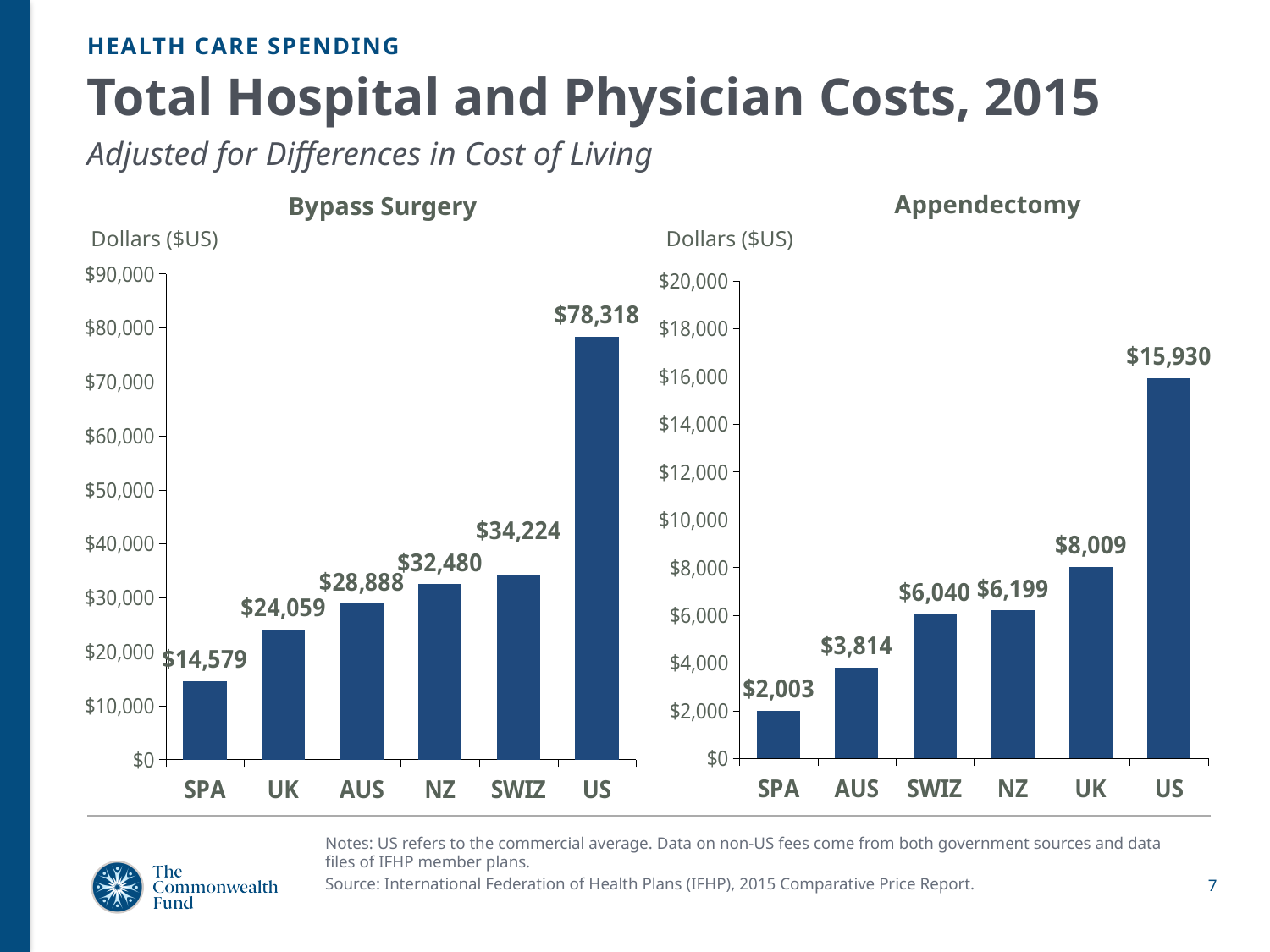
In the Bypass Surgery chart, what is the difference between the US and SWIZ values? $44,094 In the Appendectomy chart, which country has the lowest cost? SPA In the Bypass Surgery chart, which country has the highest cost? US In the Appendectomy chart, is the value for the US greater or less than $14,000? greater In the Bypass Surgery chart, do the values rise or fall from SPA to US along the x axis? Rise In the Bypass Surgery chart, what is the value for the UK? $24,059 What is the y-axis label on the Appendectomy chart? Dollars ($US) What kind of chart is the Bypass Surgery chart? Bar chart In the Bypass Surgery chart, which is larger, the value for AUS or the value for NZ? NZ In the Appendectomy chart, what is the difference between the UK and AUS values? $4,195 How many countries are shown in the Appendectomy chart? 6 In the Appendectomy chart, what is the value for NZ? $6,199